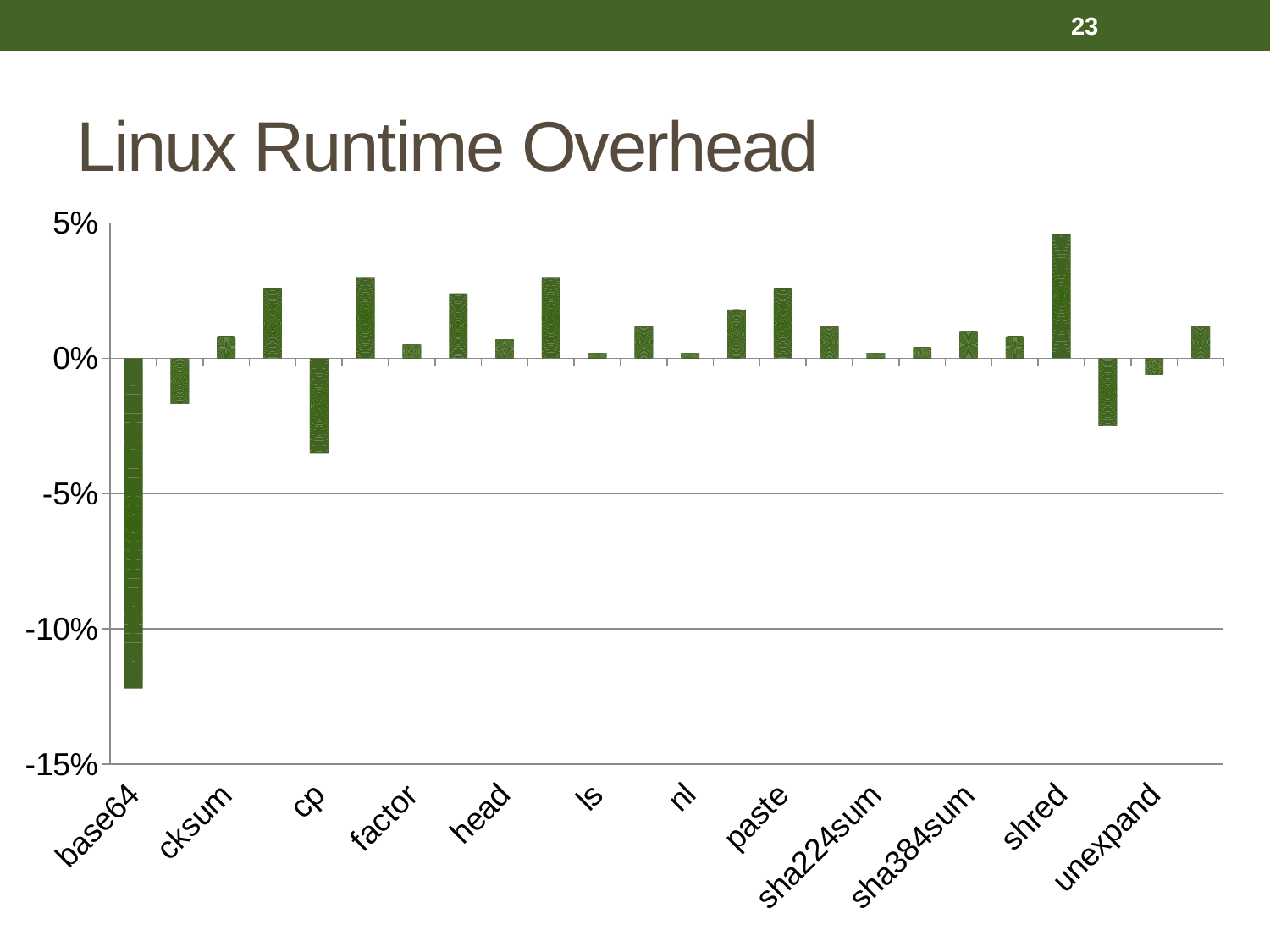
Is the value for shred greater or less than 0%? greater What is the title of the chart? Linux Runtime Overhead How many category labels are shown on the x axis? 12 Is the value for base64 greater or less than -10%? less Which category has the lowest (most negative) runtime overhead? base64 What is the lowest value shown on the y axis? -15% Is the value for cp greater or less than 0%? less Which category has the highest runtime overhead? shred Which has the larger value, base64 or shred? shred What kind of chart is shown on the slide? bar chart Which has the larger value, cp or paste? paste